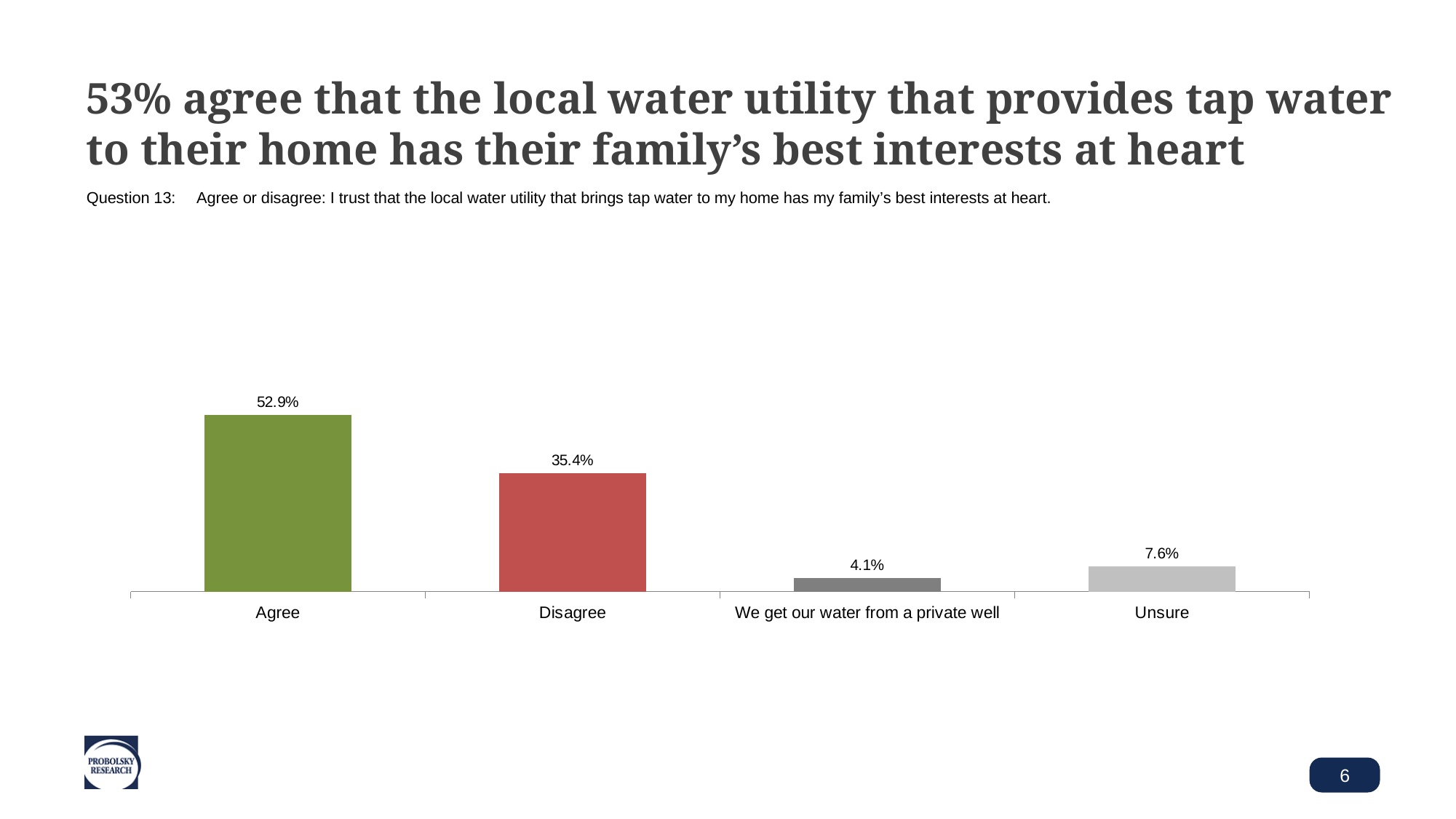
What is the value for "We get our water from a private well"? 4.1% Which category has the lowest value? We get our water from a private well What percentage of respondents were unsure? 7.6% Which is larger, the value for Unsure or the value for "We get our water from a private well"? Unsure What is the difference between the Agree and Disagree values? 17.5% What percentage of respondents said they agree? 52.9% What is the difference between the Unsure value and the private well value? 3.5% What kind of chart is shown on the slide? Bar chart What colour is the bar for Agree? Green Which category has the highest value? Agree How many categories are shown in the chart? 4 What percentage of respondents said they disagree? 35.4%